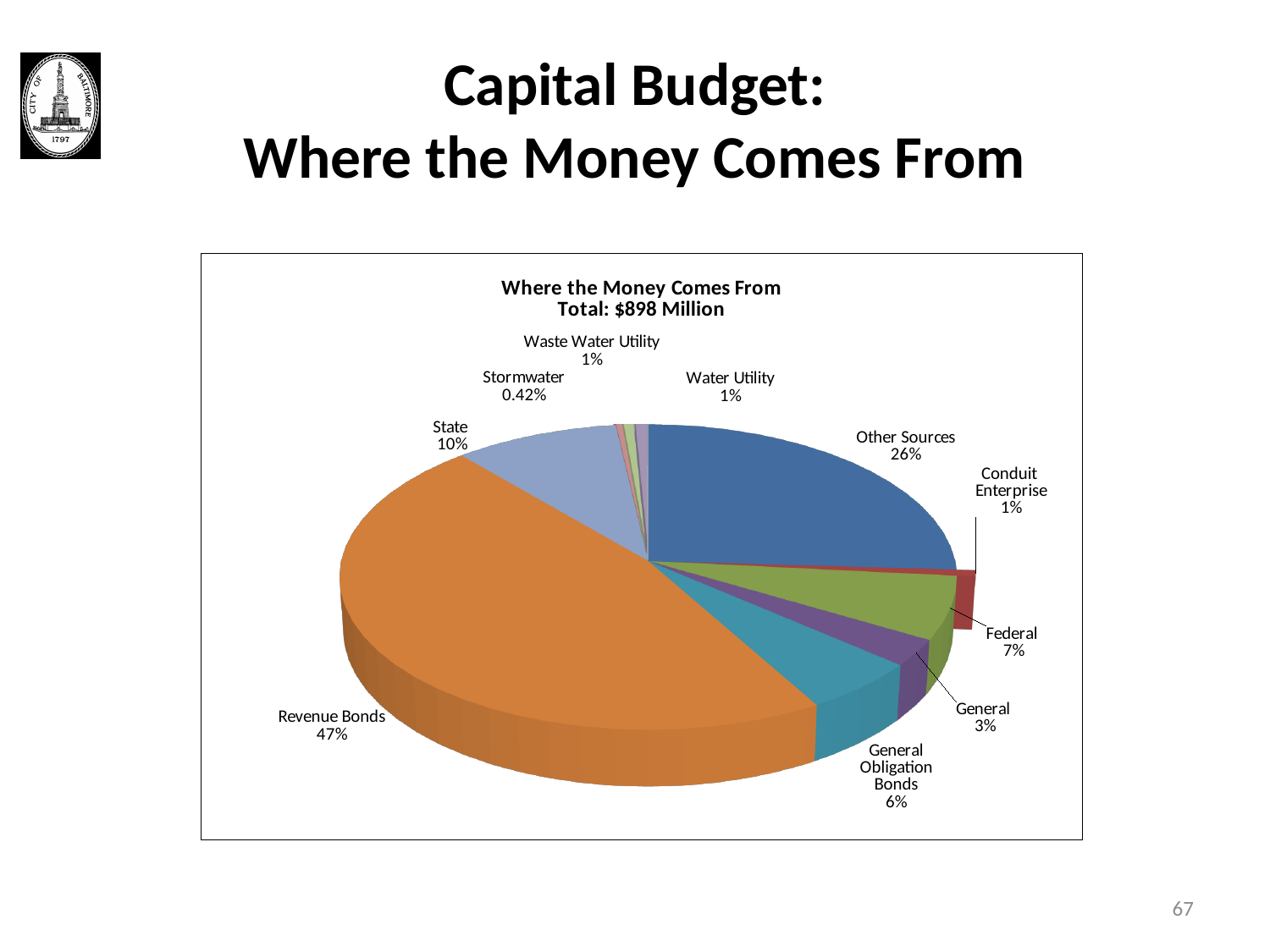
How many categories are shown in the pie chart? 10 What is the difference in percentage points between Revenue Bonds and Other Sources? 21 Which is larger, the share for Federal or the share for State? State What total amount is stated in the chart title? $898 Million What share of the pie does Revenue Bonds account for? 47% What is the value shown for Other Sources? 26% Which category has the largest slice of the pie? Revenue Bonds What kind of chart is shown on the slide? Pie chart What is the value shown for Stormwater? 0.42% What is the difference in percentage points between Federal and General? 4 Which category has the smallest slice of the pie? Stormwater What is the value shown for General Obligation Bonds? 6%